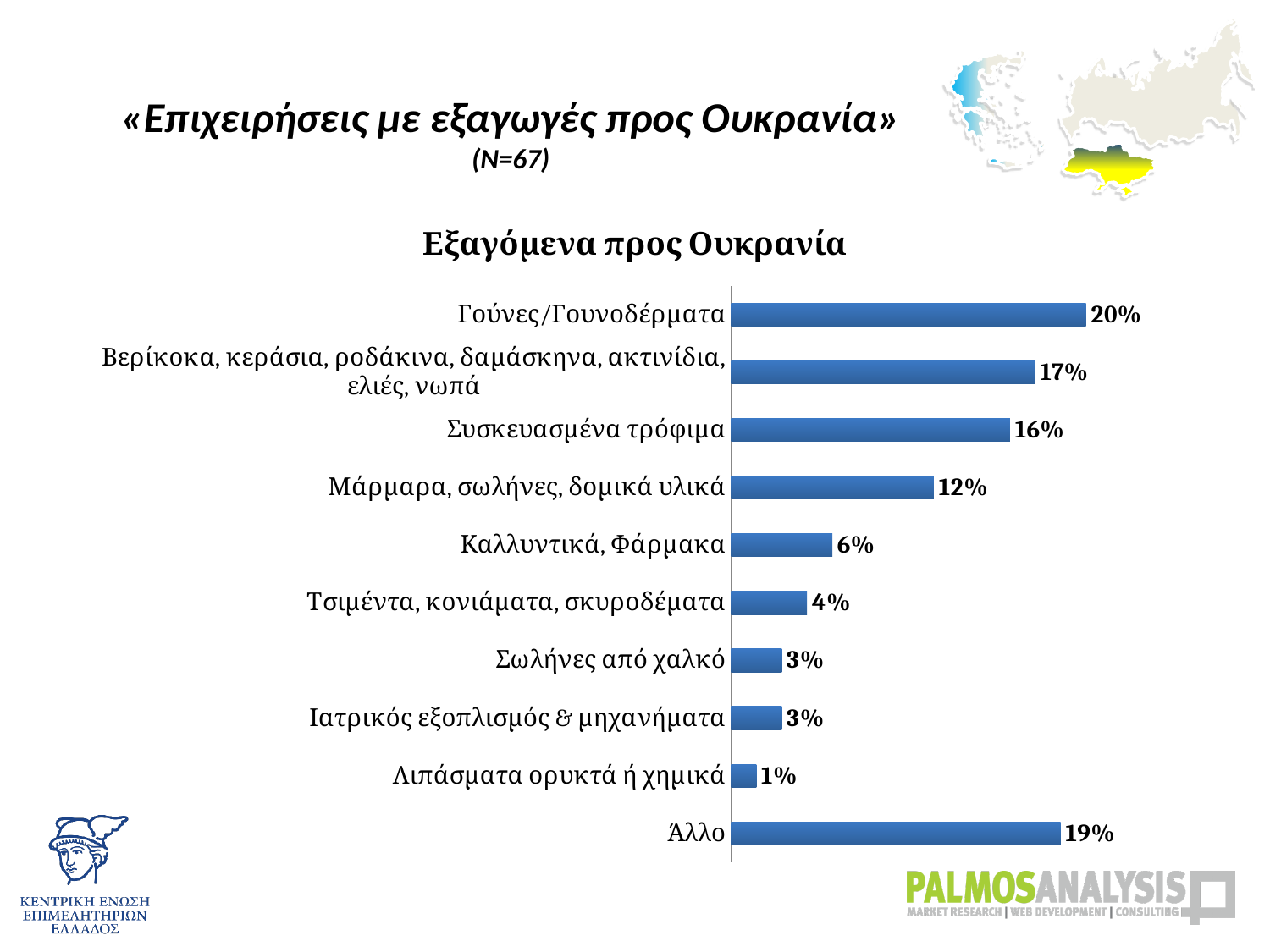
What is the value for Μάρμαρα, σωλήνες, δομικά υλικά? 12% What is the value for Γούνες/Γουνοδέρματα? 20% Which category has the highest value? Γούνες/Γουνοδέρματα What is the difference between the values for Γούνες/Γουνοδέρματα and Άλλο? 1% What is the difference between the values for Συσκευασμένα τρόφιμα and Καλλυντικά, Φάρμακα? 10% What is the value for Συσκευασμένα τρόφιμα? 16% What is the title of the chart? Εξαγόμενα προς Ουκρανία How many categories are shown in the chart? 10 What kind of chart is shown on the slide? Bar chart What is the value for Λιπάσματα ορυκτά ή χημικά? 1% Which is larger, the value for Τσιμέντα, κονιάματα, σκυροδέματα or the value for Καλλυντικά, Φάρμακα? Καλλυντικά, Φάρμακα Which category has the lowest value? Λιπάσματα ορυκτά ή χημικά